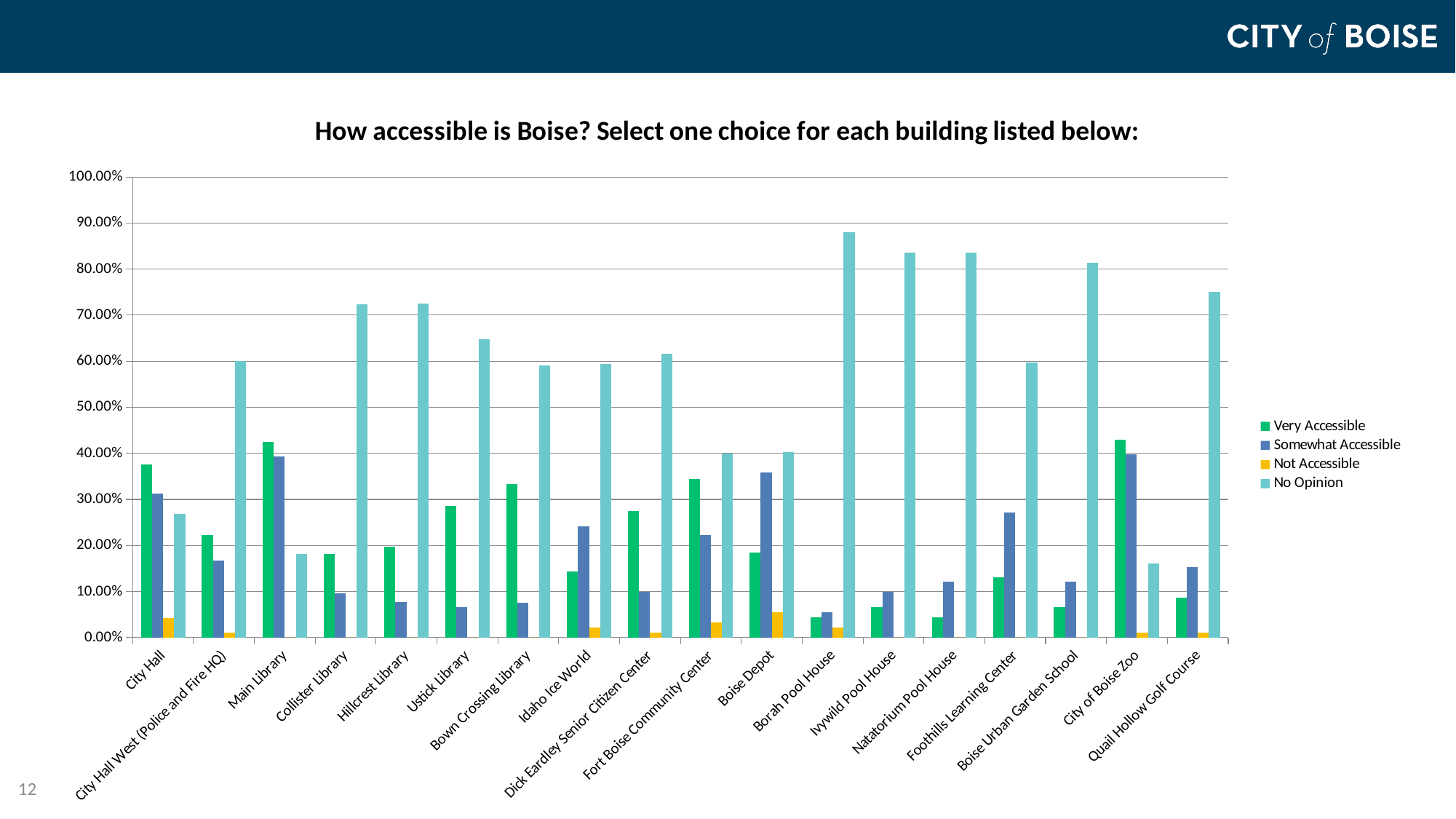
What is the title of the chart? How accessible is Boise? Select one choice for each building listed below: Is the No Opinion value for Main Library greater or less than 20.00%? less What kind of chart is shown on the slide? bar chart How many series does the legend list? 4 Is the No Opinion value for Ustick Library greater or less than 60.00%? greater Is the No Opinion value for Borah Pool House greater or less than 80.00%? greater How many buildings are listed along the x axis? 18 For Idaho Ice World, which is larger: Very Accessible or Somewhat Accessible? Somewhat Accessible For Boise Depot, which is larger: Very Accessible or Somewhat Accessible? Somewhat Accessible Which building has the highest No Opinion value? Borah Pool House